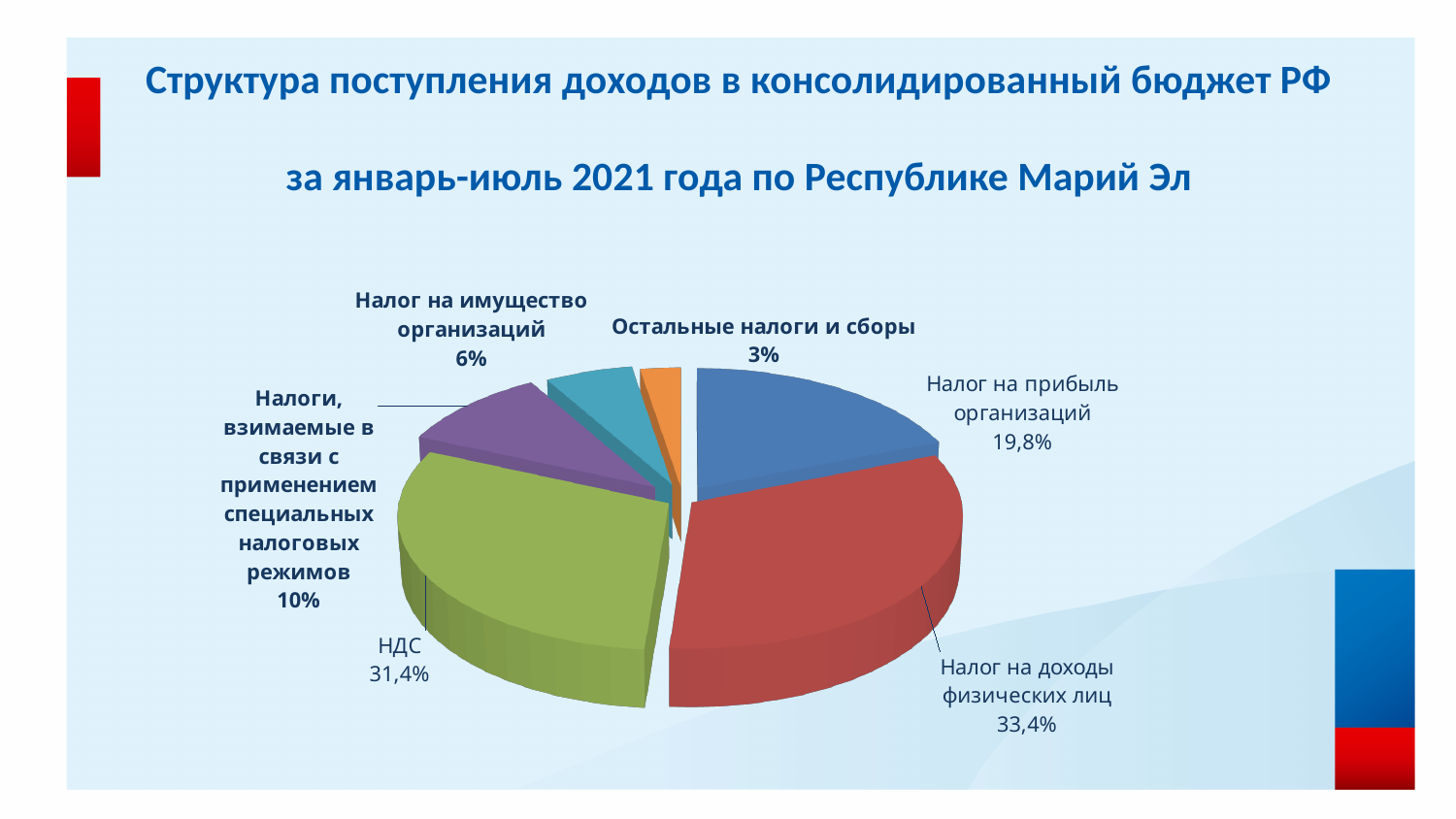
By how many percentage points does Налог на доходы физических лиц exceed НДС? 2 What share of the pie is labelled for НДС? 31,4% How many slices does the pie chart have? 6 What is the difference in percentage points between Налоги, взимаемые в связи с применением специальных налоговых режимов and Налог на имущество организаций? 4 What percentage is shown for Налог на имущество организаций? 6% Which is larger: the share for НДС or the share for Налог на прибыль организаций? НДС What percentage is shown for Остальные налоги и сборы? 3% Which category has the smallest share of the pie? Остальные налоги и сборы Which category has the largest share of the pie? Налог на доходы физических лиц What is the value shown for Налог на прибыль организаций? 19,8% What kind of chart is shown on the slide? Pie chart What period does the chart title say the data covers? январь-июль 2021 года